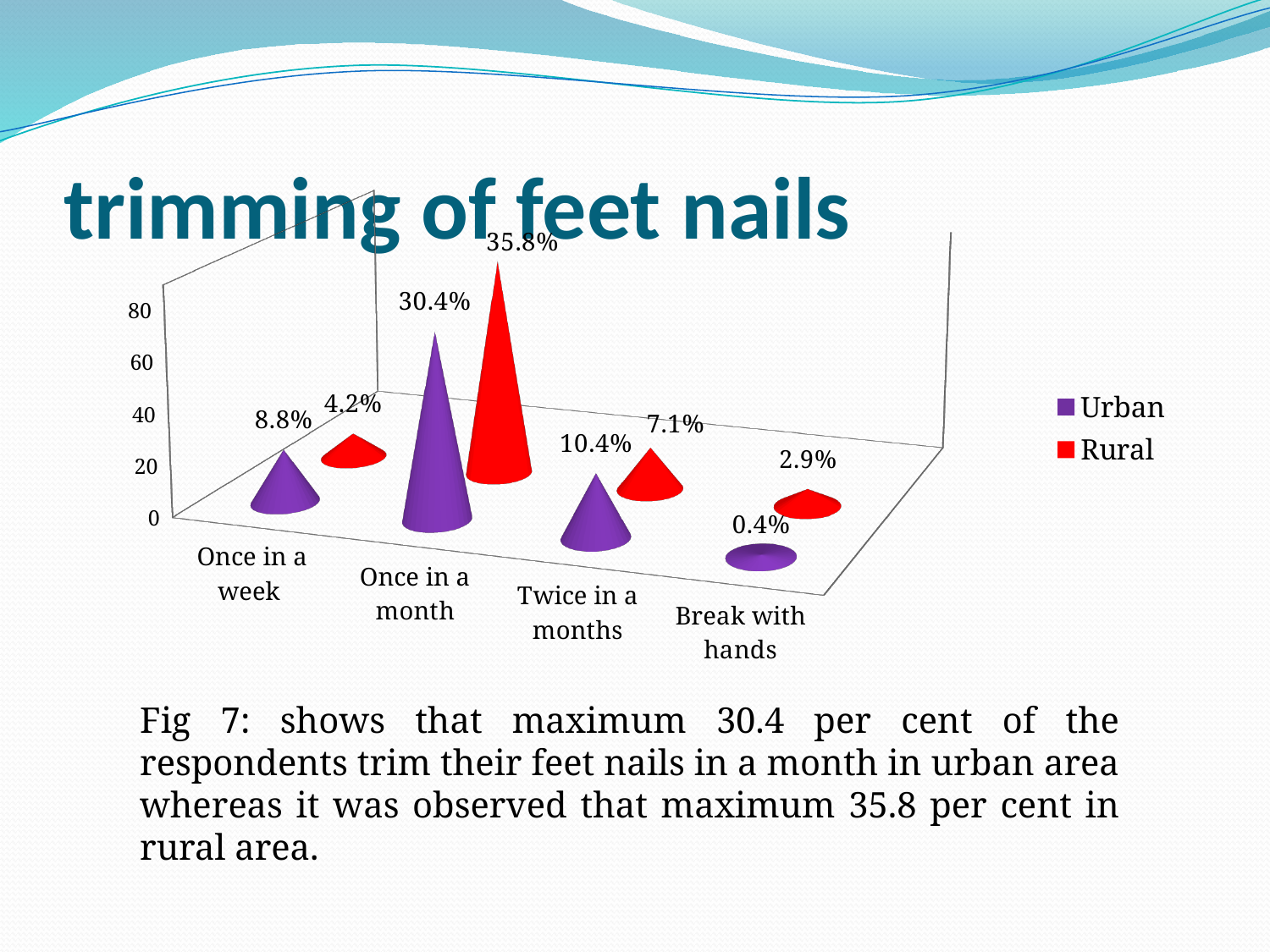
How many series does the legend list? 2 How many categories are shown on the x axis? 4 What is the urban value for 'Break with hands'? 0.4% What is the difference between the rural and urban values for 'Once in a month'? 5.4 percentage points What is the difference between the urban and rural values for 'Once in a week'? 4.6 percentage points What percentage of urban respondents trim their feet nails once in a month? 30.4% For 'Twice in a months', which is larger, the urban or the rural value? Urban Which colour represents the Rural series? Red Which category has the highest rural value? Once in a month What is the rural value for 'Twice in a months'? 7.1% What is the rural value for 'Once in a month'? 35.8% Which category has the lowest urban value? Break with hands